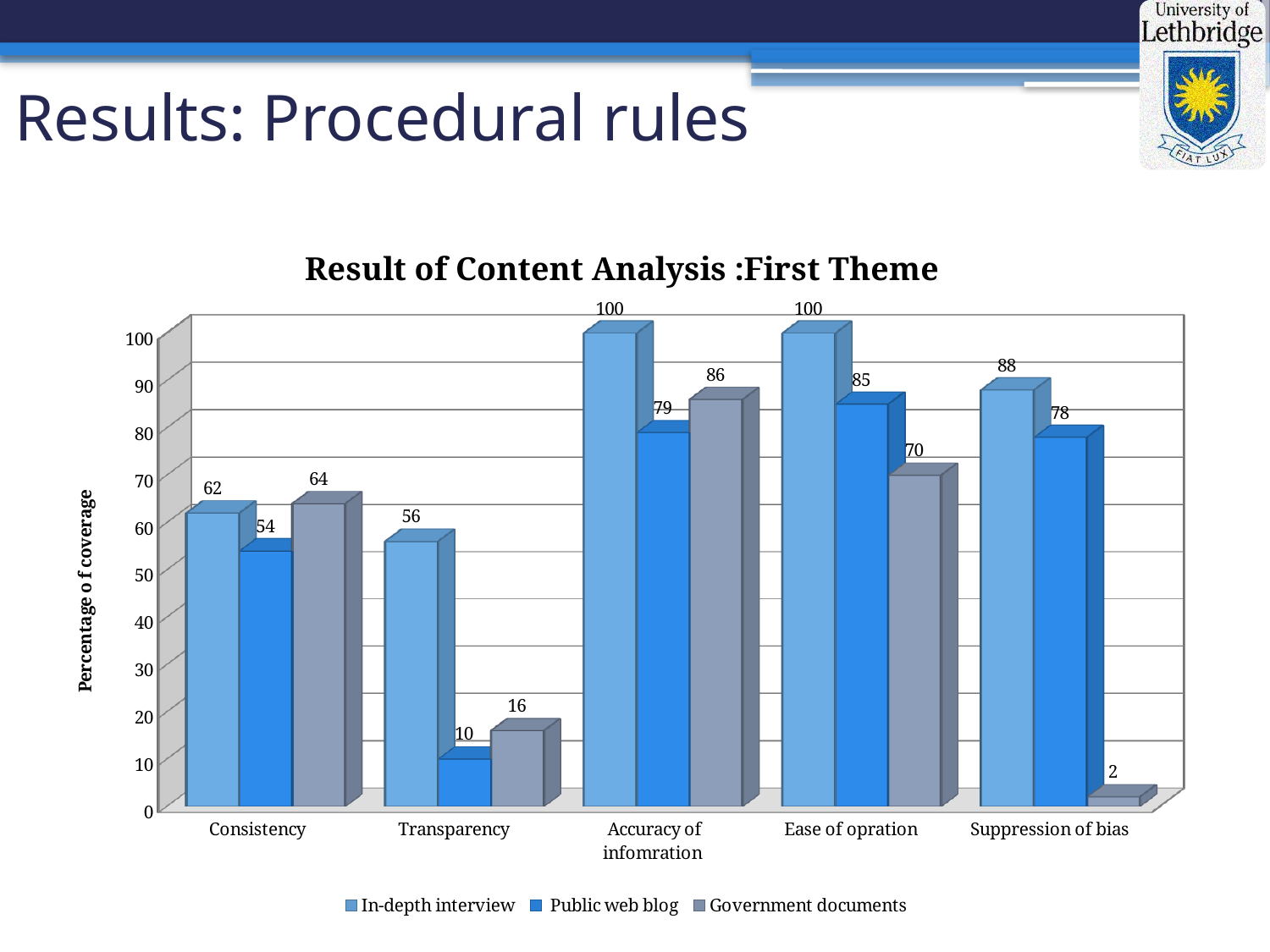
How many series does the legend list? 3 What is the value for Government documents in the Transparency category? 16 How many categories are shown on the x axis? 5 What is the value for In-depth interview in the Suppression of bias category? 88 Which category has the lowest value for Government documents? Suppression of bias Which category has the highest value for Public web blog? Ease of opration What is the difference between the In-depth interview and Public web blog values in the Transparency category? 46 What is the title of the chart? Result of Content Analysis :First Theme Which is larger in the Accuracy of infomration category: Public web blog or Government documents? Government documents What is the label of the vertical axis? Percentage o f coverage What is the value for Public web blog in the Consistency category? 54 What kind of chart is shown on the slide? Bar chart